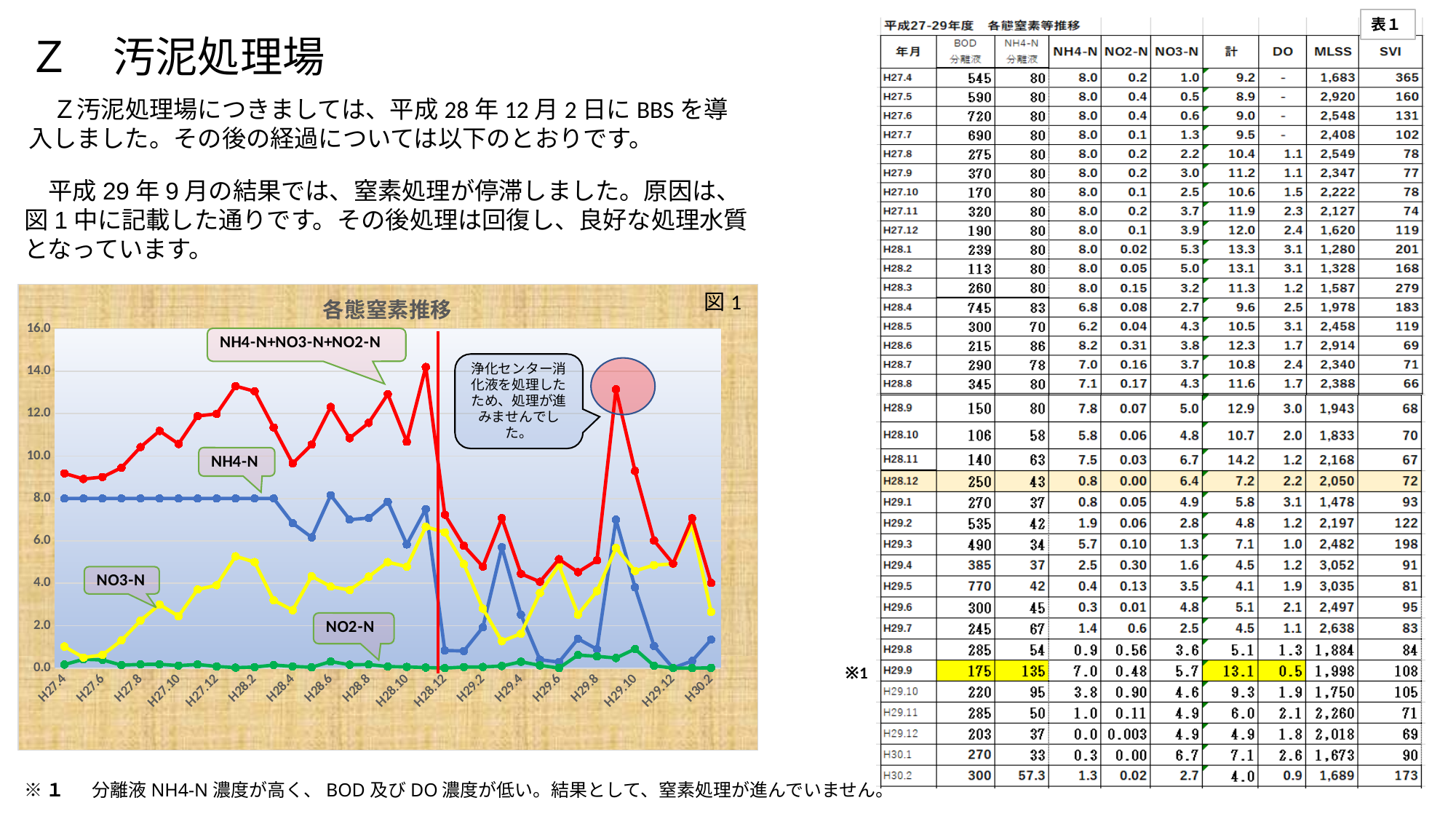
On the 各態窒素推移 chart, does the NH4-N line rise, fall or stay flat from H27.4 to H28.2? stays flat How many data series are labelled on the 各態窒素推移 chart? 4 On the 各態窒素推移 chart, at H29.9 which is larger, NH4-N or NO3-N? NH4-N What is the title of the chart in 図1? 各態窒素推移 On the 各態窒素推移 chart, which series has the highest value at H28.2? NH4-N+NO3-N+NO2-N On the 各態窒素推移 chart, what is the NH4-N value at H27.4? 8.0 On the 各態窒素推移 chart, which series has the lowest values across the whole period? NO2-N On the 各態窒素推移 chart, is the NH4-N+NO3-N+NO2-N value at H29.9 greater or less than 12.0? greater On the 各態窒素推移 chart, is the NO3-N value at H27.4 greater or less than 2.0? less On the 各態窒素推移 chart, is the NH4-N+NO3-N+NO2-N value at H28.12 greater or less than 8.0? less What kind of chart is 各態窒素推移 (図1)? line chart What colour is the NH4-N line on the 各態窒素推移 chart? blue